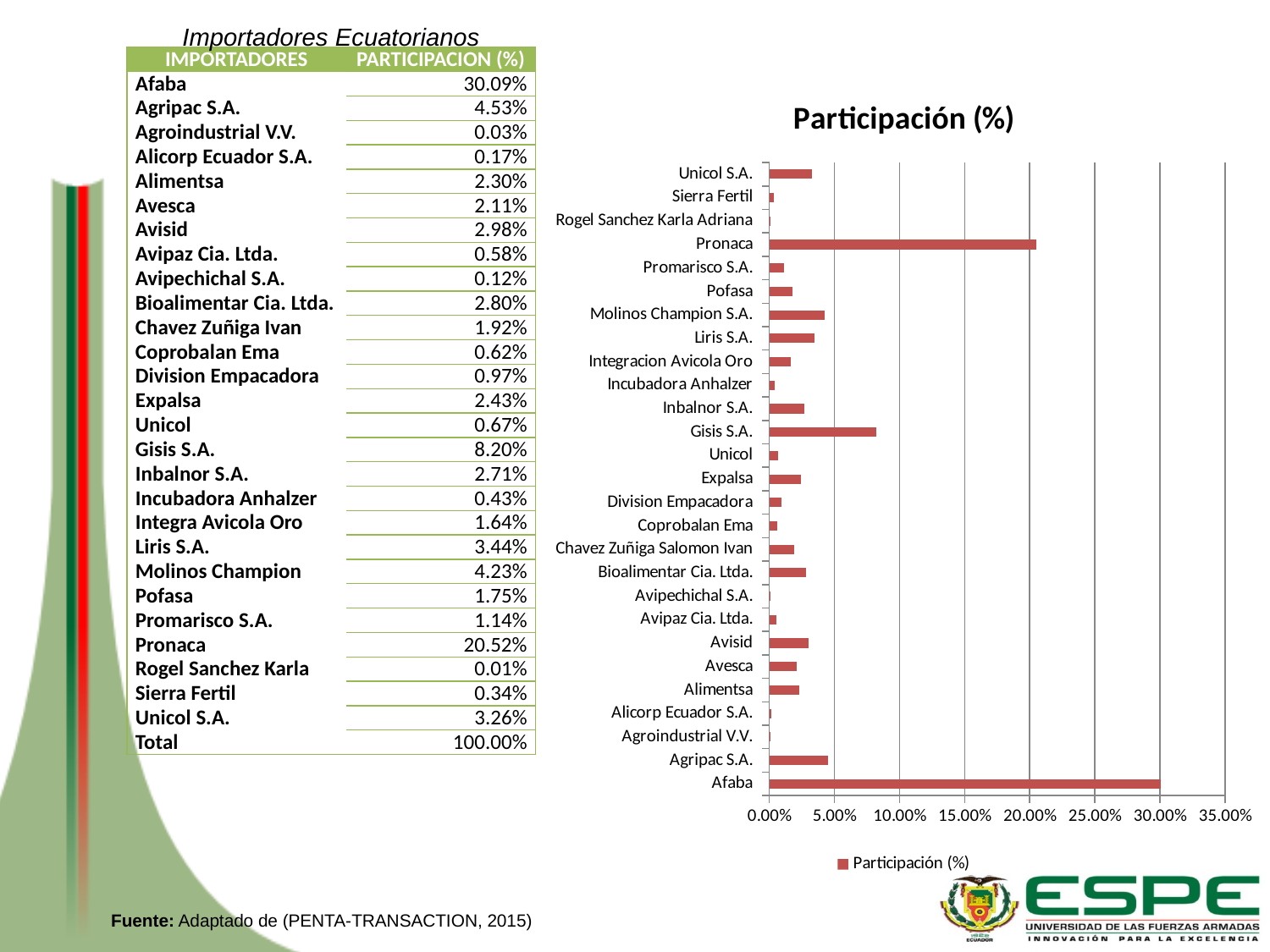
Using the table values, what is the difference in participation between Afaba and Pronaca? 9.57% Is the value for Gisis S.A. greater or less than 10.00%? less According to the table, what is the participation of Pronaca? 20.52% Which has the larger participation, Gisis S.A. or Molinos Champion S.A.? Gisis S.A. Which importer has the highest participation in the chart? Afaba What kind of chart is shown on the slide? bar chart According to the table, what is the participation of Afaba? 30.09% How many importers are plotted in the chart? 27 Is the value for Pronaca greater or less than 15.00%? greater How many series does the legend list? 1 Which has the larger participation, Unicol S.A. or Unicol? Unicol S.A. What is the title of the chart? Participación (%)